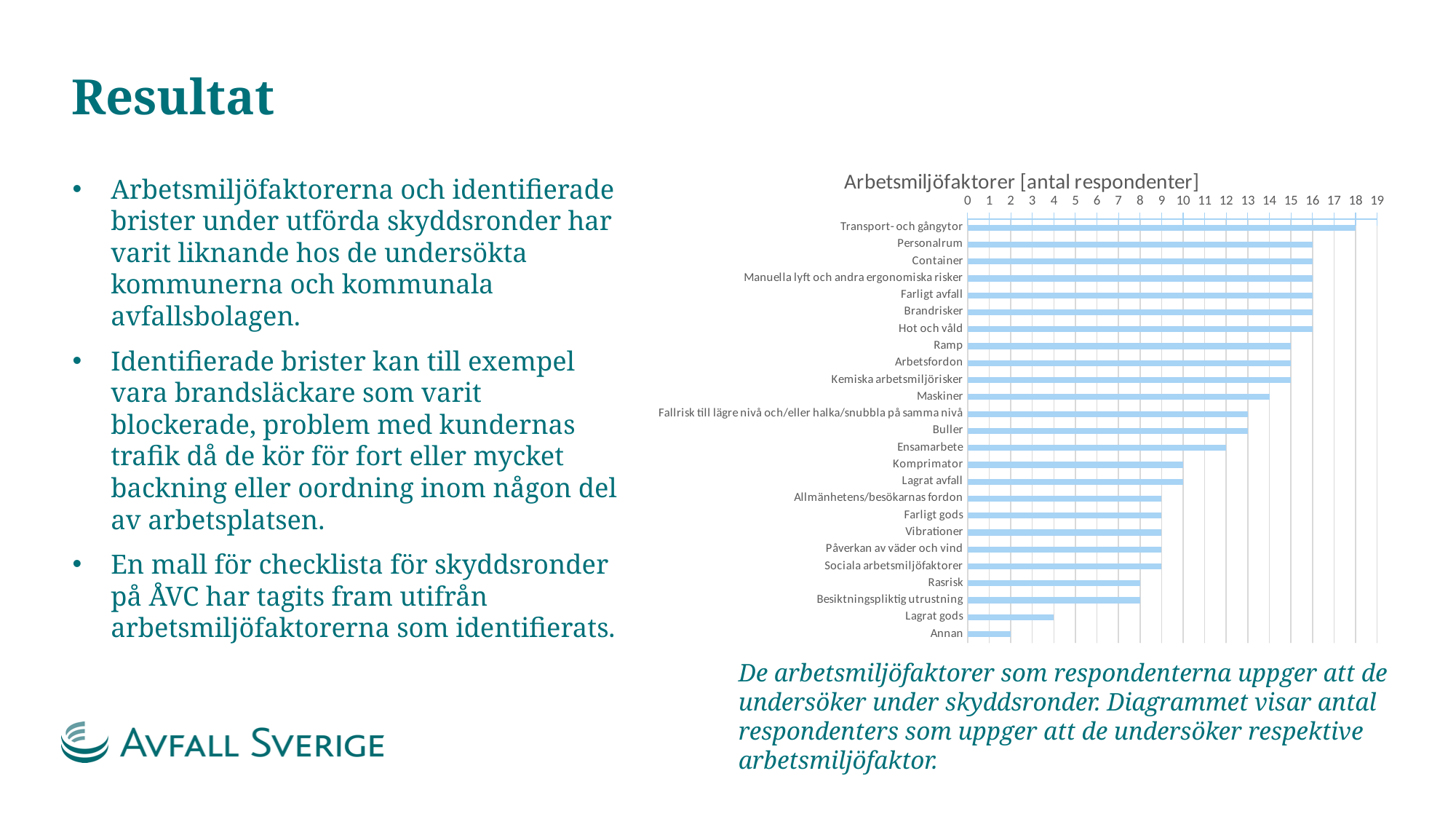
What is the title of the chart? Arbetsmiljöfaktorer [antal respondenter] What kind of chart is shown on the slide? bar chart Which has more respondents, Ensamarbete or Komprimator? Ensamarbete How many respondents are shown for Lagrat gods? 4 How many respondents are shown for Annan? 2 How many respondents are shown for Transport- och gångytor? 18 How many respondents are shown for Maskiner? 14 Which category has the lowest number of respondents? Annan Which category has the highest number of respondents? Transport- och gångytor What is the difference in respondents between Transport- och gångytor and Annan? 16 Is the value for Rasrisk greater or less than 10? less How many categories are plotted in the chart? 25